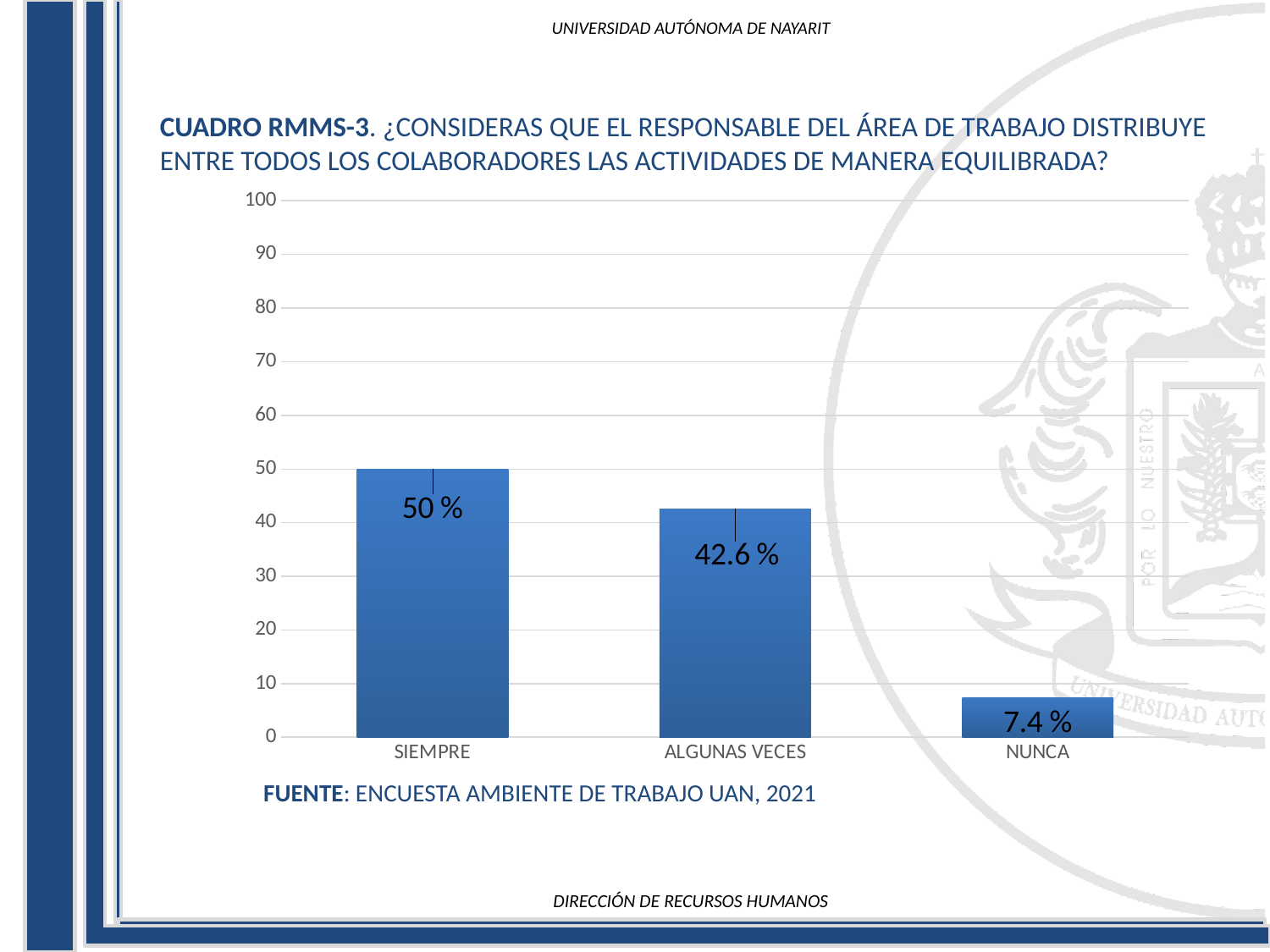
What is the value for ALGUNAS VECES? 42.6 % What is the value for NUNCA? 7.4 % Is the value for ALGUNAS VECES greater or less than 40? greater What kind of chart is shown on the slide? bar chart How many categories are shown on the x axis? 3 Which is larger, the value for ALGUNAS VECES or the value for NUNCA? ALGUNAS VECES What is the value for SIEMPRE? 50 % What is the difference between the values for SIEMPRE and ALGUNAS VECES? 7.4 % Which category has the lowest value? NUNCA Do the values rise or fall from left to right along the x axis? fall Which category has the highest value? SIEMPRE What is the difference between the values for ALGUNAS VECES and NUNCA? 35.2 %